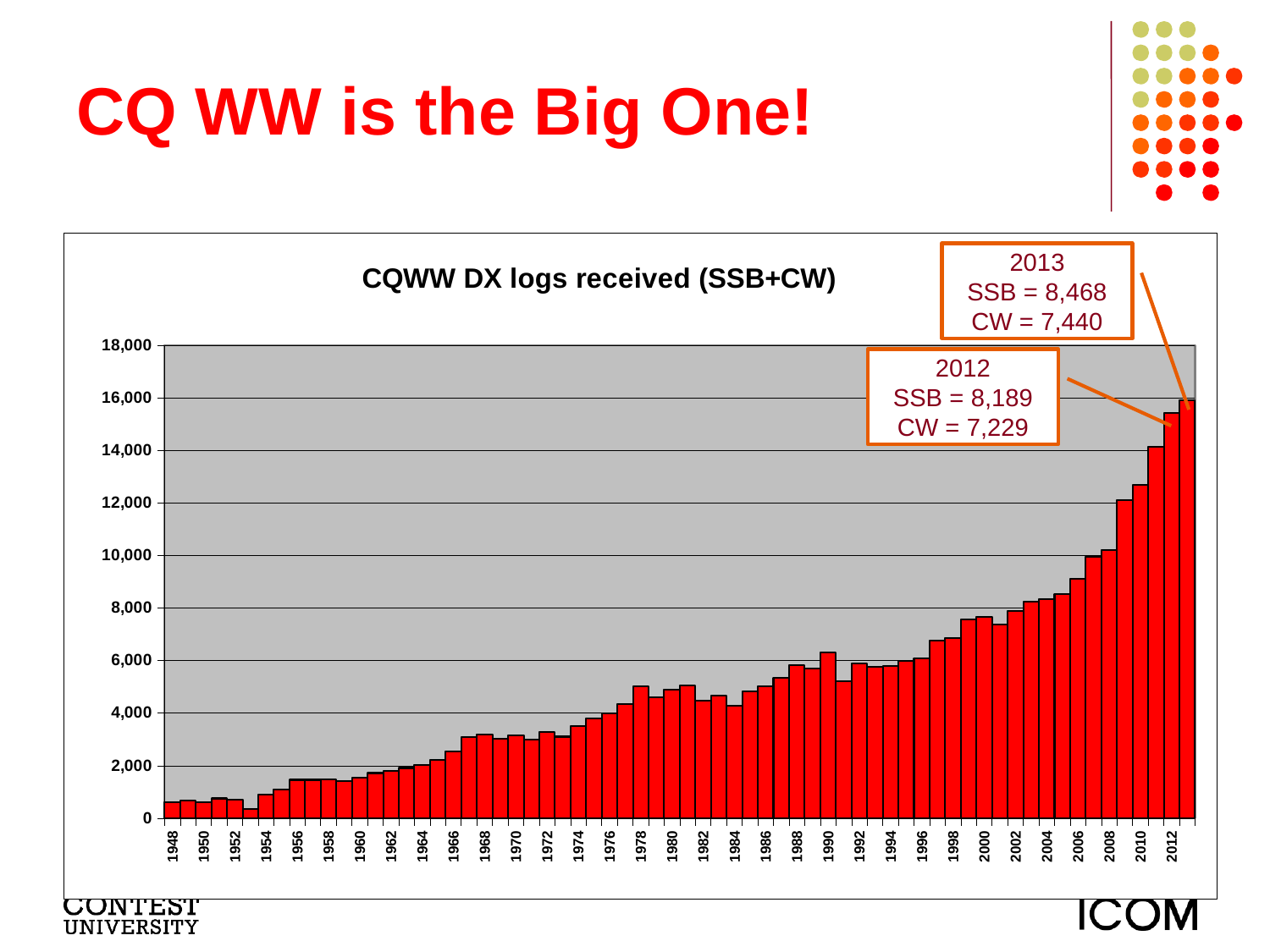
According to the annotation, how many SSB logs were received in 2013? 8,468 What kind of chart is shown on the slide? bar chart According to the annotation, how many CW logs were received in 2012? 7,229 What is the total of SSB and CW logs for 2012 as given in the annotation? 15,418 Is the value for 2010 greater or less than 12,000? greater Overall, do the number of logs received rise or fall from 1948 to 2013? rise In 2013, how many more SSB logs than CW logs were received? 1,028 Which was larger in 2012, the number of SSB logs or the number of CW logs? SSB What is the total of SSB and CW logs for 2013 as given in the annotation? 15,908 Which year has the highest bar in the chart? 2013 Is the value for 1948 greater or less than 2,000? less What is the title of the chart? CQWW DX logs received (SSB+CW)